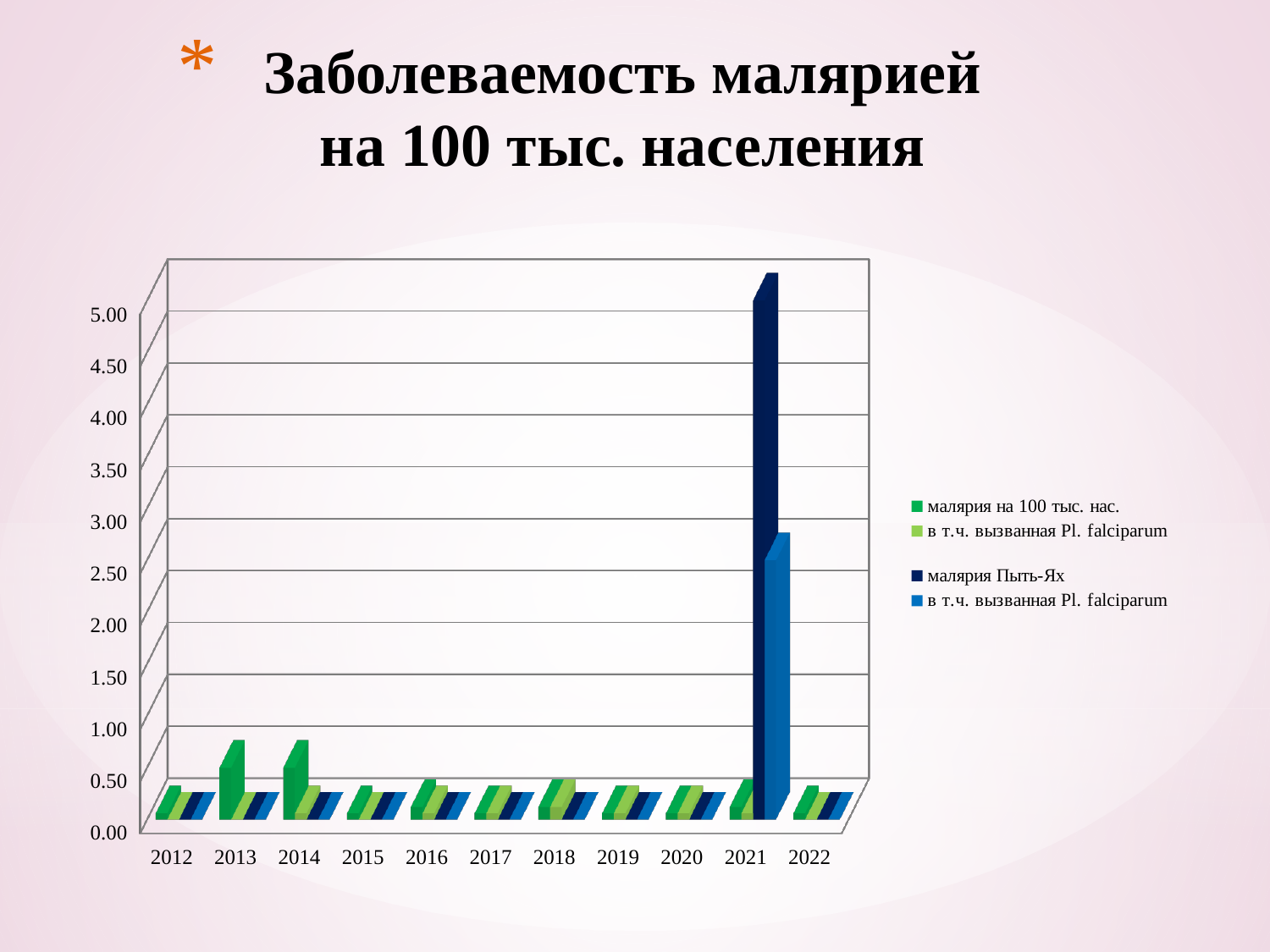
In which year is the value for "малярия Пыть-Ях" highest? 2021 In 2021, which is larger: "малярия Пыть-Ях" or its "в т.ч. вызванная Pl. falciparum" part? малярия Пыть-Ях How many years are shown on the x axis of the chart? 11 Which is larger: the value for "малярия на 100 тыс. нас." in 2013 or in 2015? 2013 How many series does the chart legend list? 4 Is the value for "малярия на 100 тыс. нас." in 2015 greater or less than 0.50? less What is the first entry in the chart legend? малярия на 100 тыс. нас. Is the value for "малярия на 100 тыс. нас." in 2013 greater or less than 1.00? less What kind of chart is shown on the slide? bar chart What is the title of the slide? Заболеваемость малярией на 100 тыс. населения